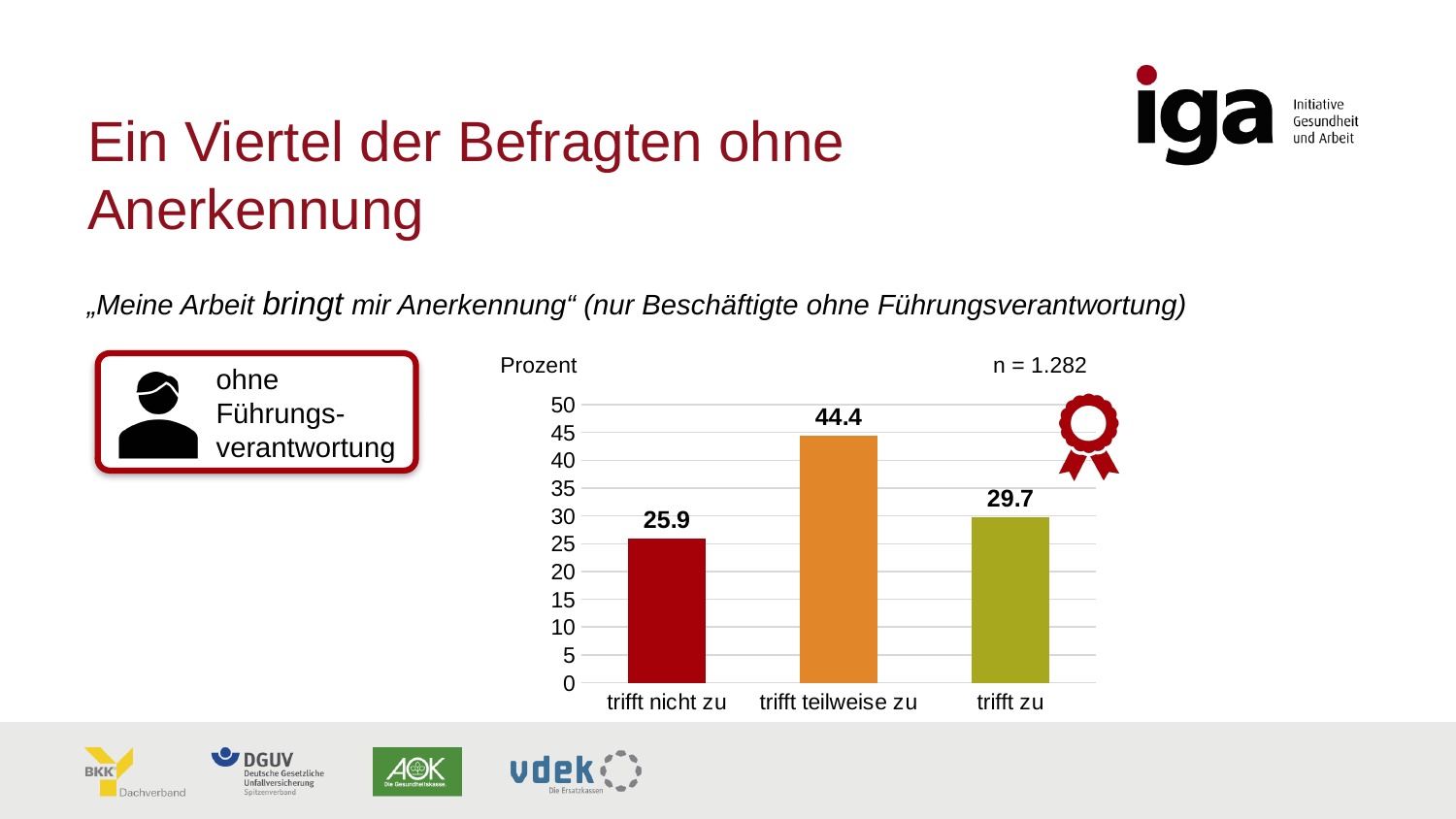
What is the value for "trifft nicht zu"? 25.9 Is the value for "trifft teilweise zu" greater or less than 40? greater What kind of chart is shown on the slide? bar chart Which is larger, the value for "trifft zu" or the value for "trifft nicht zu"? trifft zu What is the value for "trifft teilweise zu"? 44.4 What is the difference between the values for "trifft teilweise zu" and "trifft nicht zu"? 18.5 Which category has the highest value? trifft teilweise zu Which category has the lowest value? trifft nicht zu How many categories are shown on the x axis? 3 What is the difference between the values for "trifft zu" and "trifft nicht zu"? 3.8 What is the sample size (n) stated above the chart? n = 1.282 What is the value for "trifft zu"? 29.7